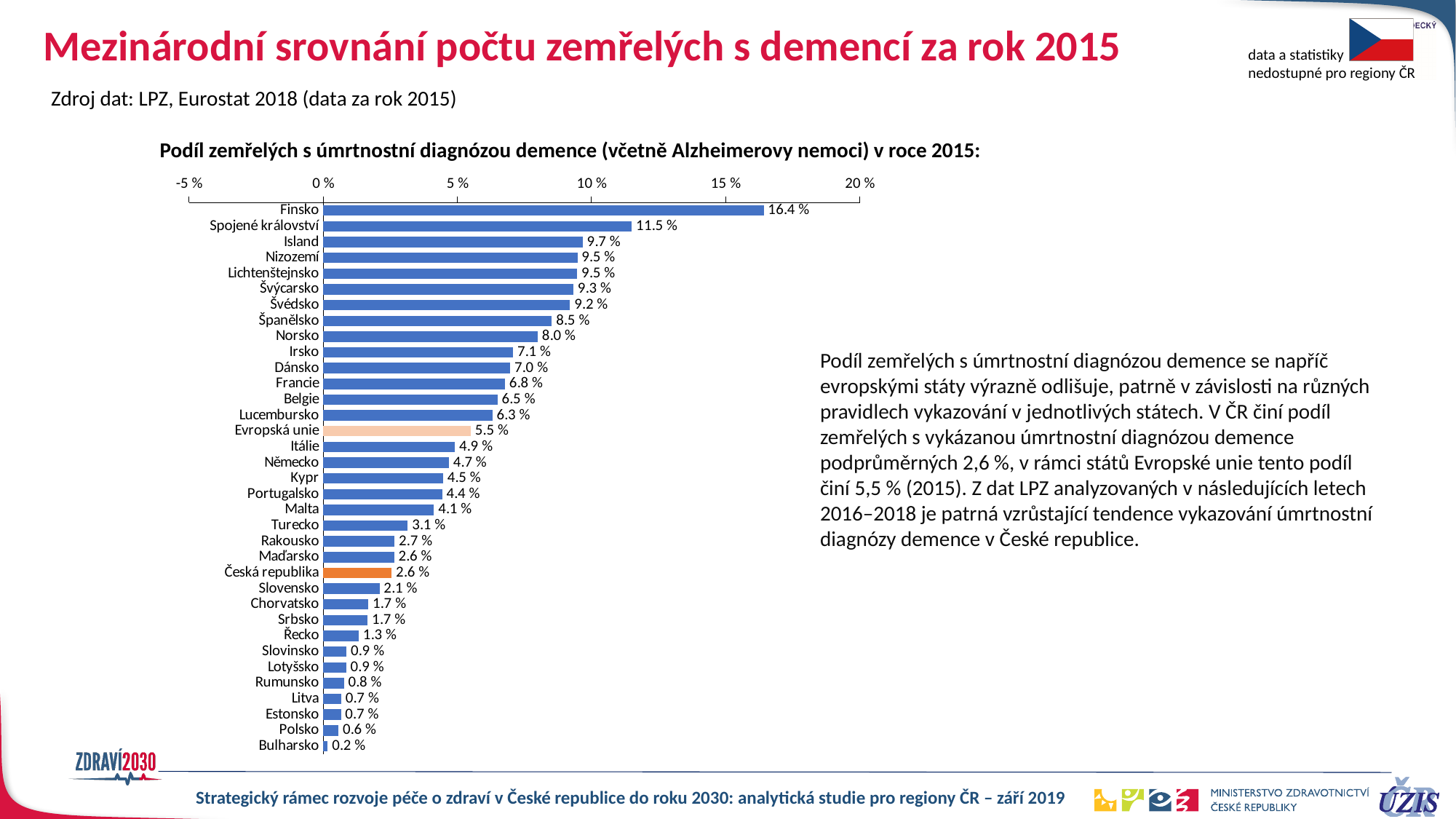
Which bar is highlighted in orange? Česká republika What is the difference between the values for Finsko and Spojené království? 4.9 % Which country has the lowest value? Bulharsko What is the difference between the values for Evropská unie and Česká republika? 2.9 % What is the value for Finsko? 16.4 % What is the value for Spojené království? 11.5 % Which country has the highest value? Finsko How many categories (bars) are shown in the chart? 35 What kind of chart is shown on the slide? Bar chart Which has a larger value, Norsko or Irsko? Norsko What is the value for Česká republika? 2.6 % What is the value for Evropská unie? 5.5 %